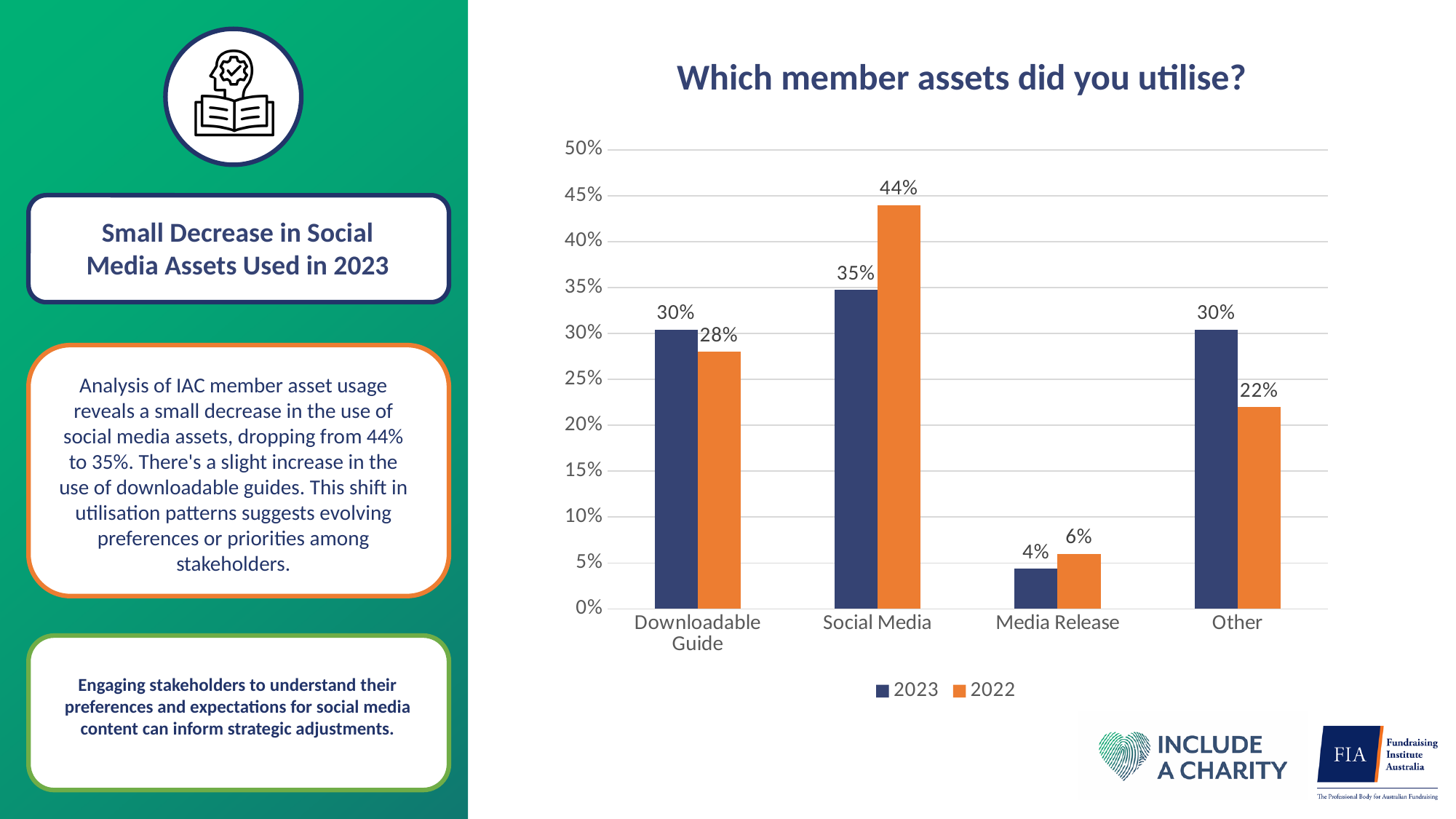
What is the 2022 value for Downloadable Guide? 28% What kind of chart is shown on the slide? Bar chart What is the 2023 value for Media Release? 4% How many categories are shown on the x axis? 4 What is the difference between the 2022 and 2023 values for Social Media? 9% Which category has the highest 2022 value? Social Media How many series does the legend list? 2 Which is larger for Other: the 2023 value or the 2022 value? 2023 What is the title of the chart? Which member assets did you utilise? What is the 2023 value for Social Media? 35% Which category has the lowest 2023 value? Media Release What is the 2022 value for Other? 22%